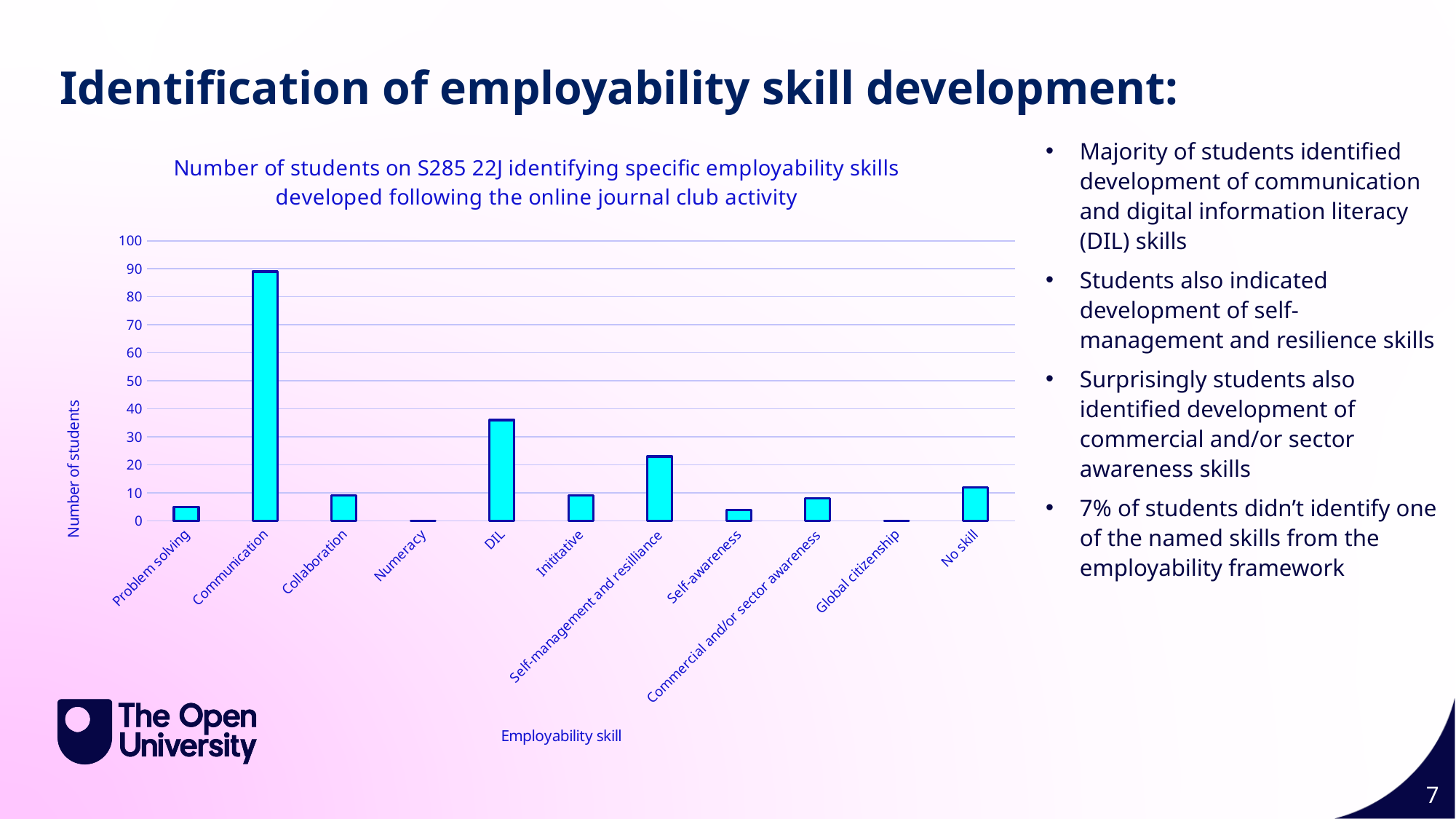
Is the value for Self-management and resilliance greater or less than 20? greater Is the value for No skill greater or less than 20? less Which is larger, the value for No skill or the value for Self-awareness? No skill Is the value for Problem solving greater or less than 10? less What kind of chart is shown on the slide? bar chart What is the label of the y axis? Number of students How many employability skill categories are shown on the x axis? 11 Which is larger, the value for DIL or the value for Self-management and resilliance? DIL What is the label of the x axis? Employability skill Which employability skill has the highest number of students? Communication